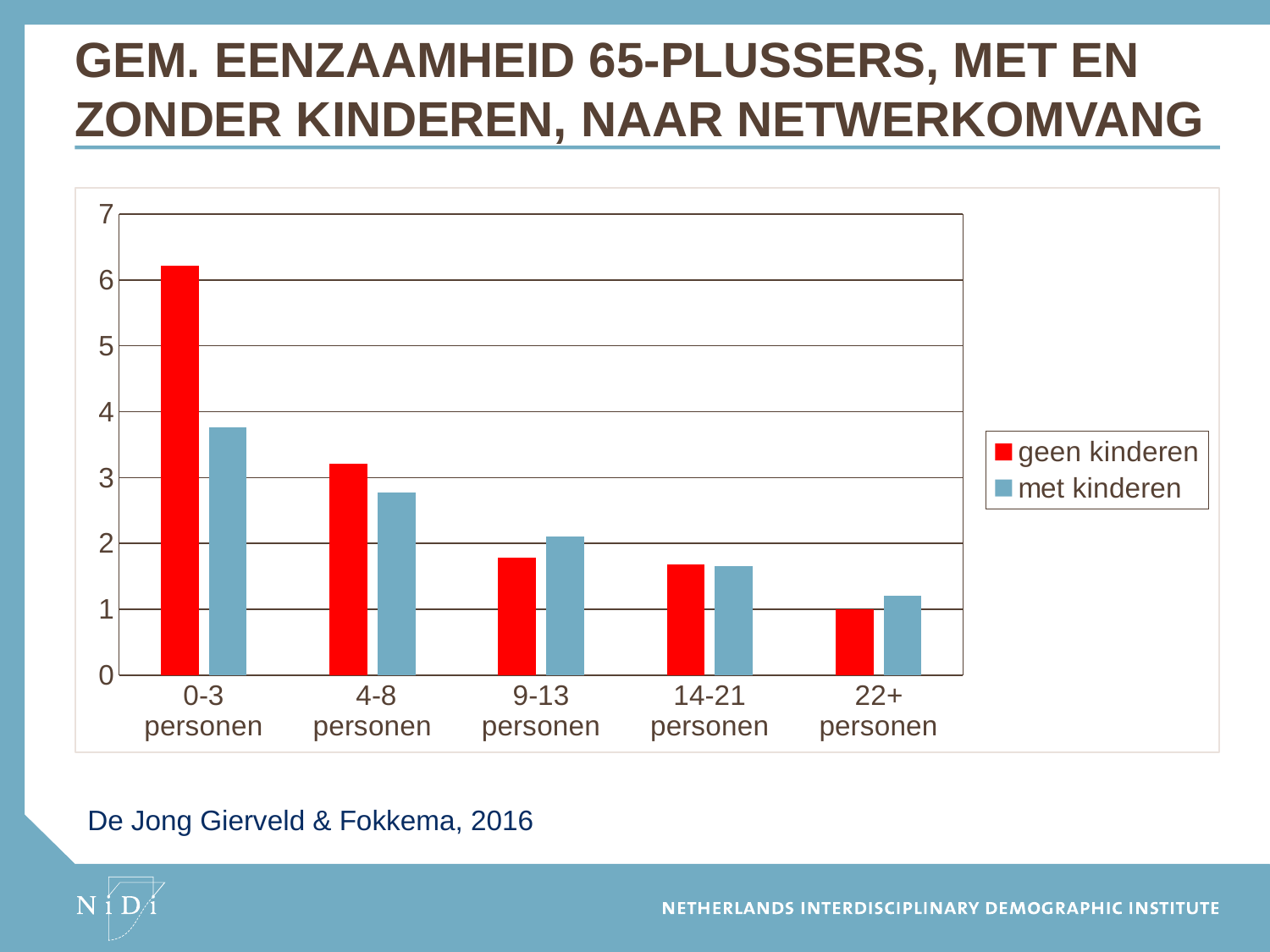
Is the value for 'met kinderen' at 0-3 personen greater or less than 4? less For 0-3 personen, which series has the larger value: 'geen kinderen' or 'met kinderen'? geen kinderen How many network-size categories are shown on the x axis? 5 For 9-13 personen, which series has the larger value: 'geen kinderen' or 'met kinderen'? met kinderen Is the value for 'geen kinderen' at 0-3 personen greater or less than 6? greater Which network-size category has the lowest value for 'met kinderen'? 22+ personen Which network-size category has the highest value for 'geen kinderen'? 0-3 personen How many series does the legend list? 2 Which colour represents the 'met kinderen' series in the legend? blue What kind of chart is shown on the slide? bar chart Is the value for 'geen kinderen' at 14-21 personen greater or less than 2? less Do the values for 'geen kinderen' rise or fall as network size increases along the x axis? fall